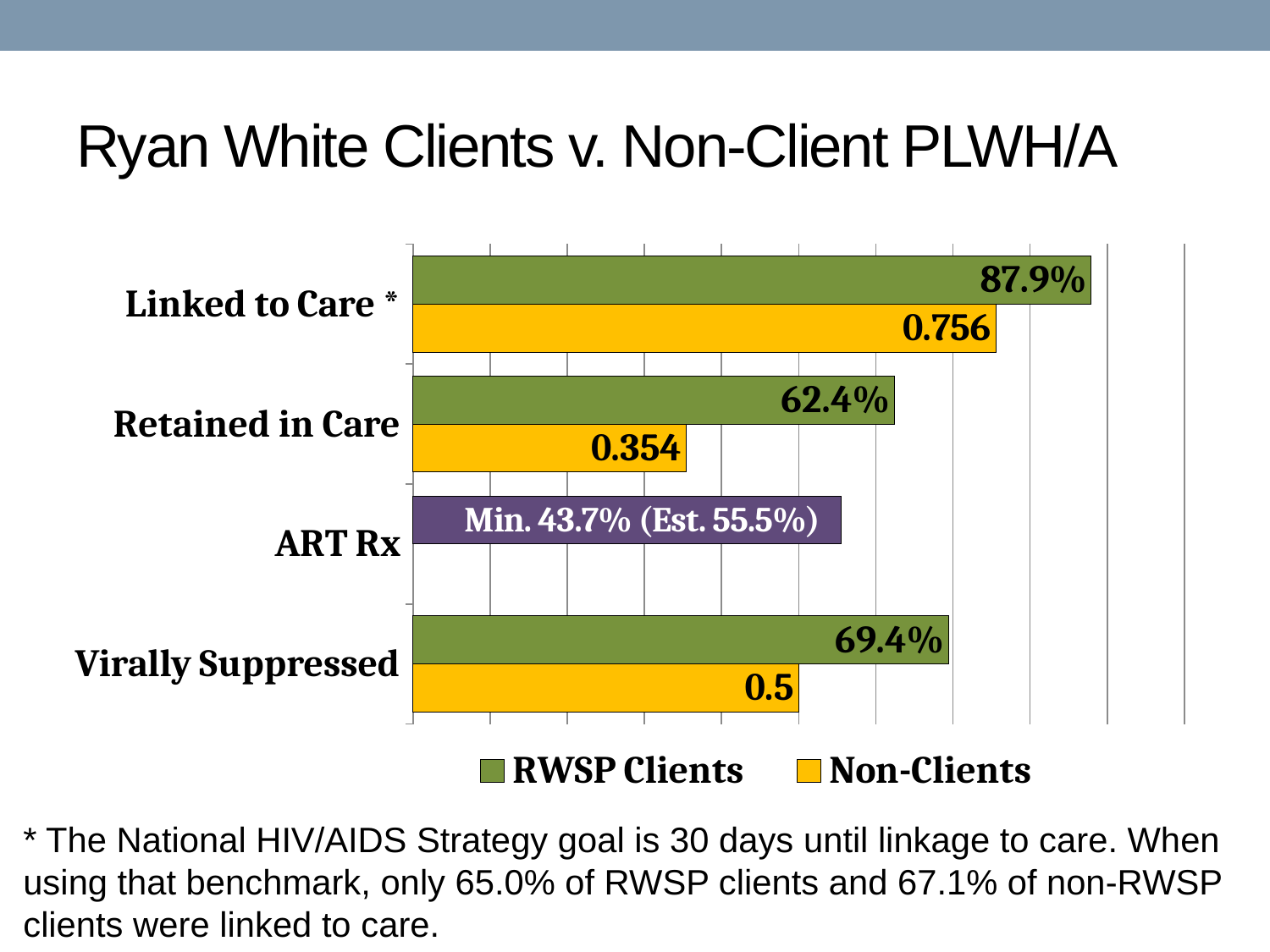
In the Retained in Care category, which series has the larger value, RWSP Clients or Non-Clients? RWSP Clients How many series does the legend list? 2 How many categories are shown on the chart? 4 Which category has the lowest value for Non-Clients? Retained in Care What is the value for Non-Clients in the Virally Suppressed category? 0.5 What is the value for Non-Clients in the Linked to Care * category? 0.756 What is the value for RWSP Clients in the Retained in Care category? 62.4% What kind of chart is shown on the slide? Bar chart Which category has the highest value for RWSP Clients? Linked to Care * What is the difference between the RWSP Clients values for Linked to Care * and Virally Suppressed? 18.5% What is the value for Non-Clients in the Retained in Care category? 0.354 What is the value for RWSP Clients in the Linked to Care * category? 87.9%